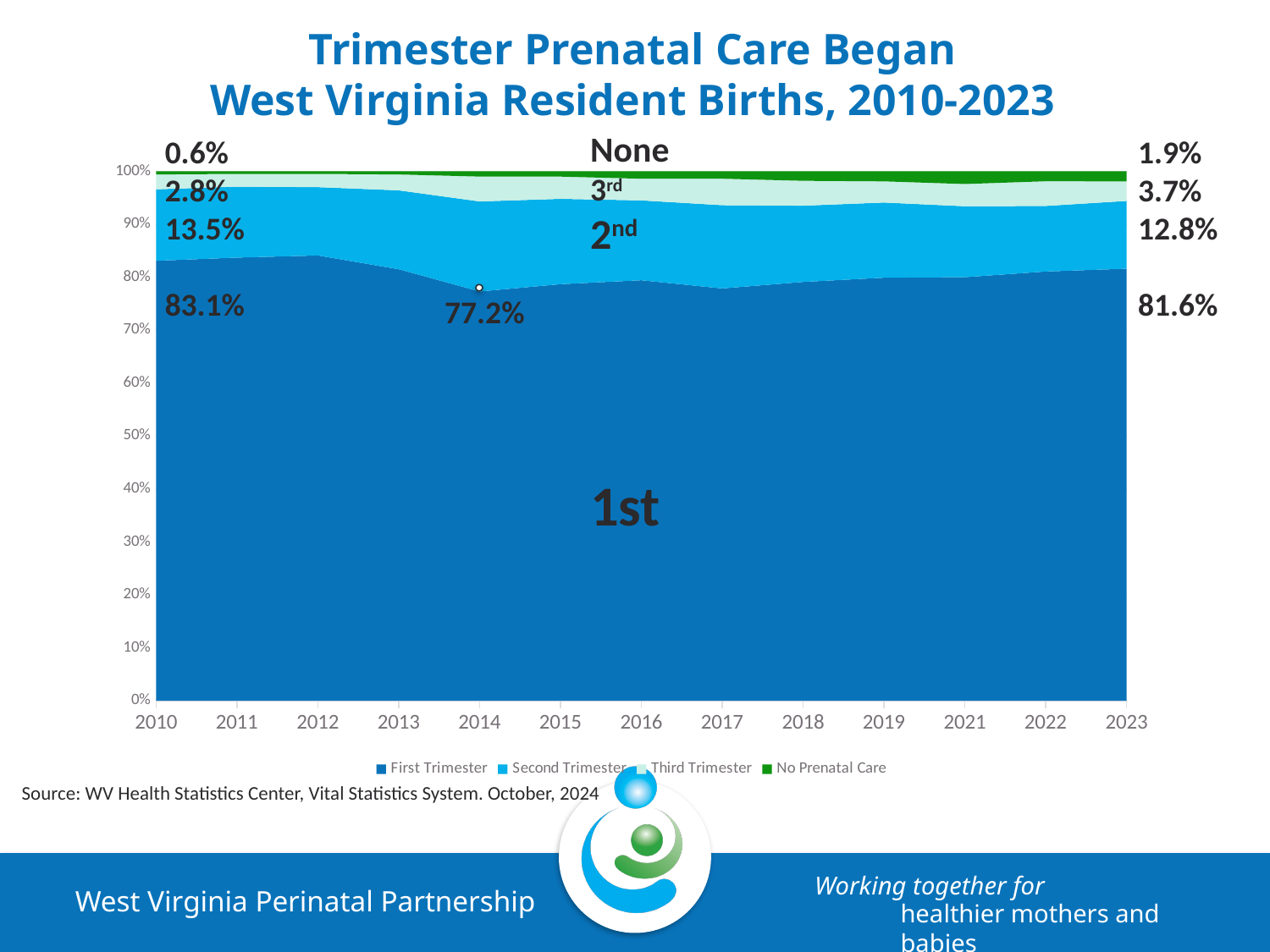
What kind of chart is shown on the slide? Stacked area chart Which is larger: the share with no prenatal care in 2010 or in 2023? 2023 What is the labeled first-trimester value for 2014? 77.2% How many series does the legend list? 4 What percentage of West Virginia resident births had prenatal care begin in the first trimester in 2010? 83.1% What percentage of births had prenatal care begin in the second trimester in 2010? 13.5% What percentage of births had prenatal care begin in the third trimester in 2023? 3.7% What percentage of births had prenatal care begin in the first trimester in 2023? 81.6% By how many percentage points did the first-trimester share change from 2010 to 2023? 1.5 percentage points lower What percentage of births had no prenatal care in 2023? 1.9% How many year labels appear on the x axis? 13 What is the title of the chart? Trimester Prenatal Care Began West Virginia Resident Births, 2010-2023